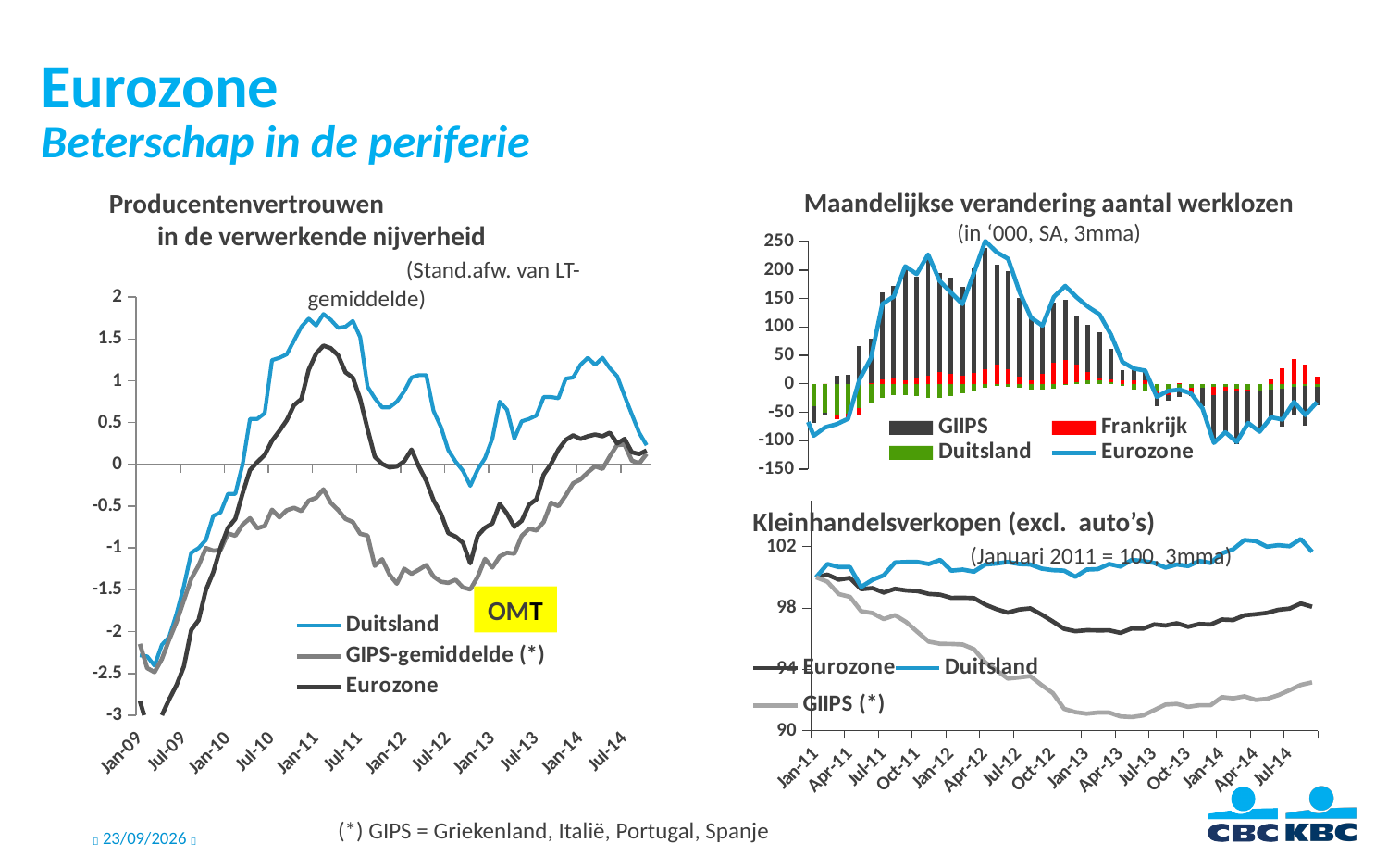
How many series does the legend of the 'Maandelijkse verandering aantal werklozen' chart list? 4 In the 'Producentenvertrouwen in de verwerkende nijverheid' chart, is the value for Duitsland at Jan-11 greater or less than 1? greater In the 'Kleinhandelsverkopen (excl. auto's)' chart, does the GIIPS (*) line rise or fall from Jan-11 to Jan-13? fall How many series does the legend of the 'Kleinhandelsverkopen (excl. auto's)' chart list? 3 What kind of chart is the 'Producentenvertrouwen in de verwerkende nijverheid' chart? line chart According to the footnote on the slide, which countries does GIPS stand for? Griekenland, Italië, Portugal, Spanje In the 'Kleinhandelsverkopen (excl. auto's)' chart, is the value for Duitsland at Jul-14 greater or less than 98? greater How many series does the legend of the 'Producentenvertrouwen in de verwerkende nijverheid' chart list? 3 In the 'Maandelijkse verandering aantal werklozen' chart, is the highest value of the Eurozone line greater or less than 200? greater In the 'Kleinhandelsverkopen (excl. auto's)' chart, which series is higher at Jan-13, Duitsland or GIIPS (*)? Duitsland